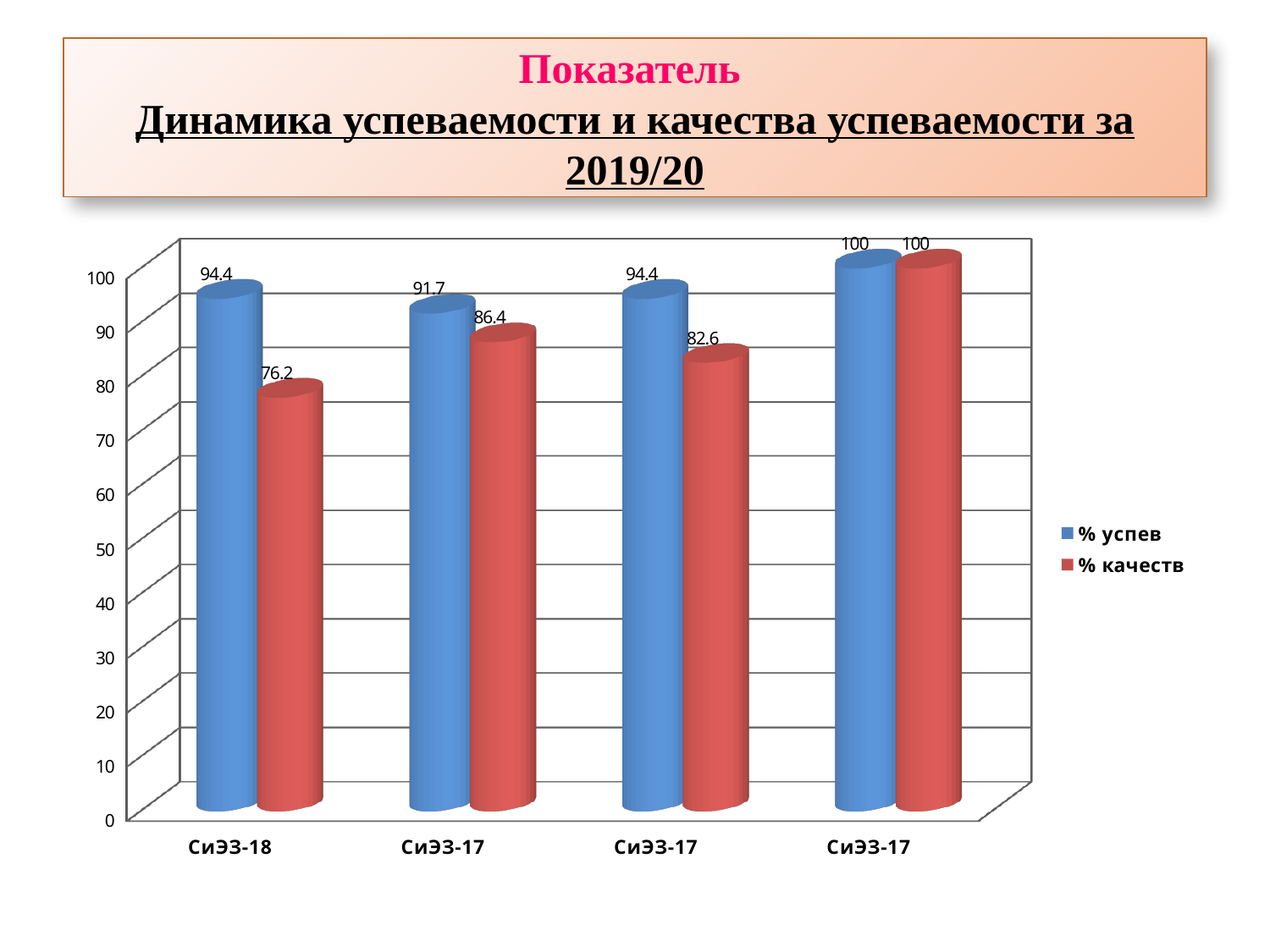
How many series does the legend list? 2 What is the value of % качеств for the second category from the left (the first СиЭЗ-17)? 86.4 What is the value of % успев for СиЭЗ-18? 94.4 What is the value of % качеств for СиЭЗ-18? 76.2 What is the value of % успев for the second category from the left (the first СиЭЗ-17)? 91.7 What is the difference between % успев and % качеств for СиЭЗ-18? 18.2 How many categories are shown on the x axis? 4 What kind of chart is shown on the slide? Bar chart What is the value of % качеств for the third category from the left? 82.6 Which category has the lowest % качеств value? СиЭЗ-18 For СиЭЗ-18, which is larger: % успев or % качеств? % успев What is the value of % качеств for the rightmost category? 100